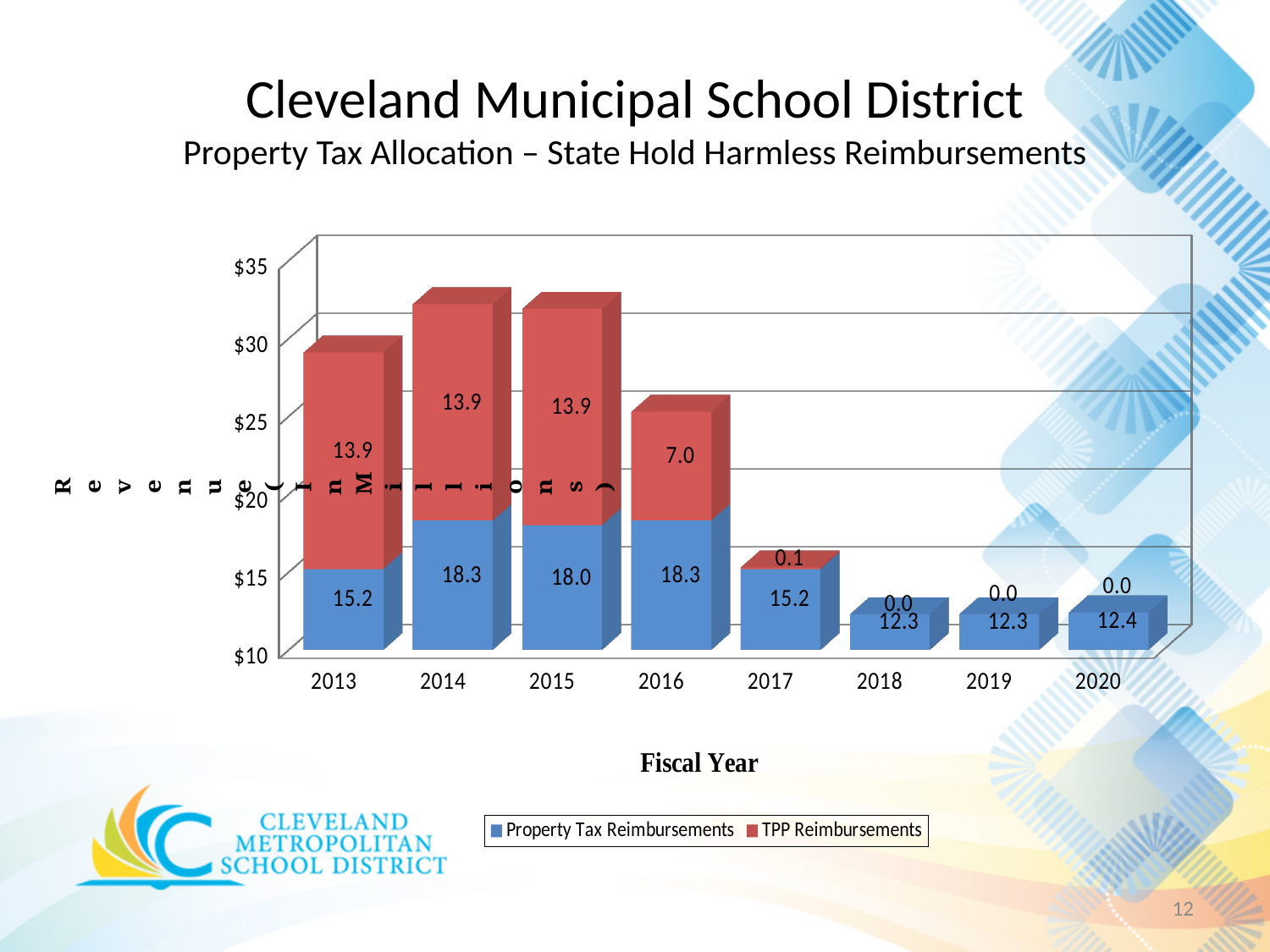
What is the total of the stacked bar for fiscal year 2016? 25.3 How many fiscal years are shown on the x axis? 8 Is the top of the stacked bar for 2013 greater or less than $25? greater Which is larger, the Property Tax Reimbursements value for 2016 or for 2017? 2016 How many series does the legend list? 2 Which fiscal year has the tallest stacked bar overall? 2014 What is the Property Tax Reimbursements value for fiscal year 2020? 12.4 What is the TPP Reimbursements value for fiscal year 2016? 7.0 What kind of chart is shown on the slide? Stacked bar chart What is the difference between the TPP Reimbursements values for 2015 and 2016? 6.9 What is the TPP Reimbursements value for fiscal year 2017? 0.1 What is the Property Tax Reimbursements value for fiscal year 2014? 18.3